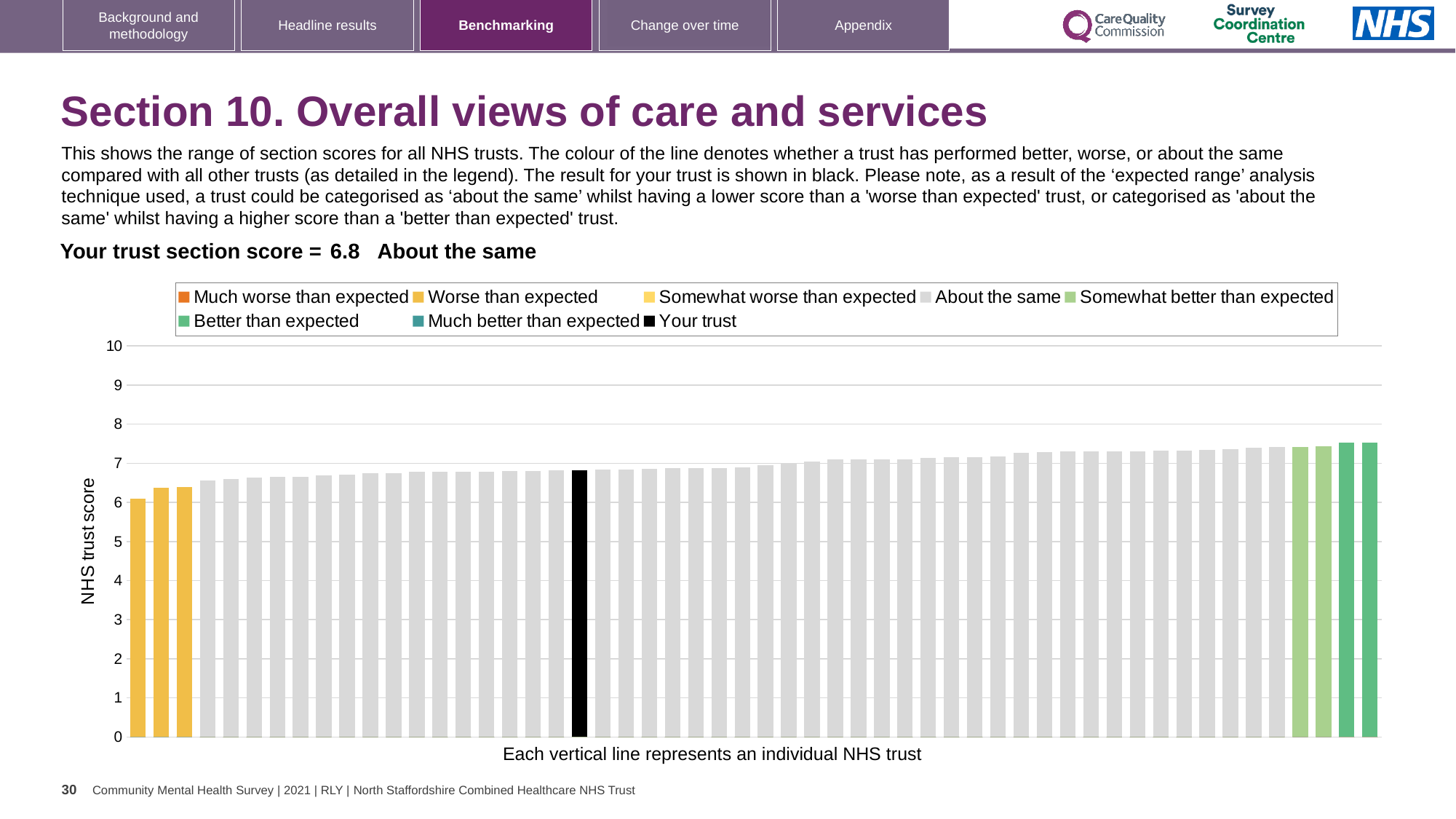
Do the bar values rise or fall from left to right along the x axis? rise What is the section score for your trust? 6.8 What colour is used for the bar representing your trust? black How many trusts are shown as 'Worse than expected' (yellow bars)? 3 Is the lowest trust score on the chart greater or less than 7? less Is the highest trust score on the chart greater or less than 8? less What is the label on the vertical axis of the chart? NHS trust score Is the value for your trust (the black bar) greater or less than 5? greater How many entries does the chart legend list? 8 How many trusts are shown as 'Better than expected' (dark green bars)? 2 Which benchmarking category is your trust placed in for this section? About the same What kind of chart is shown on the slide? bar chart